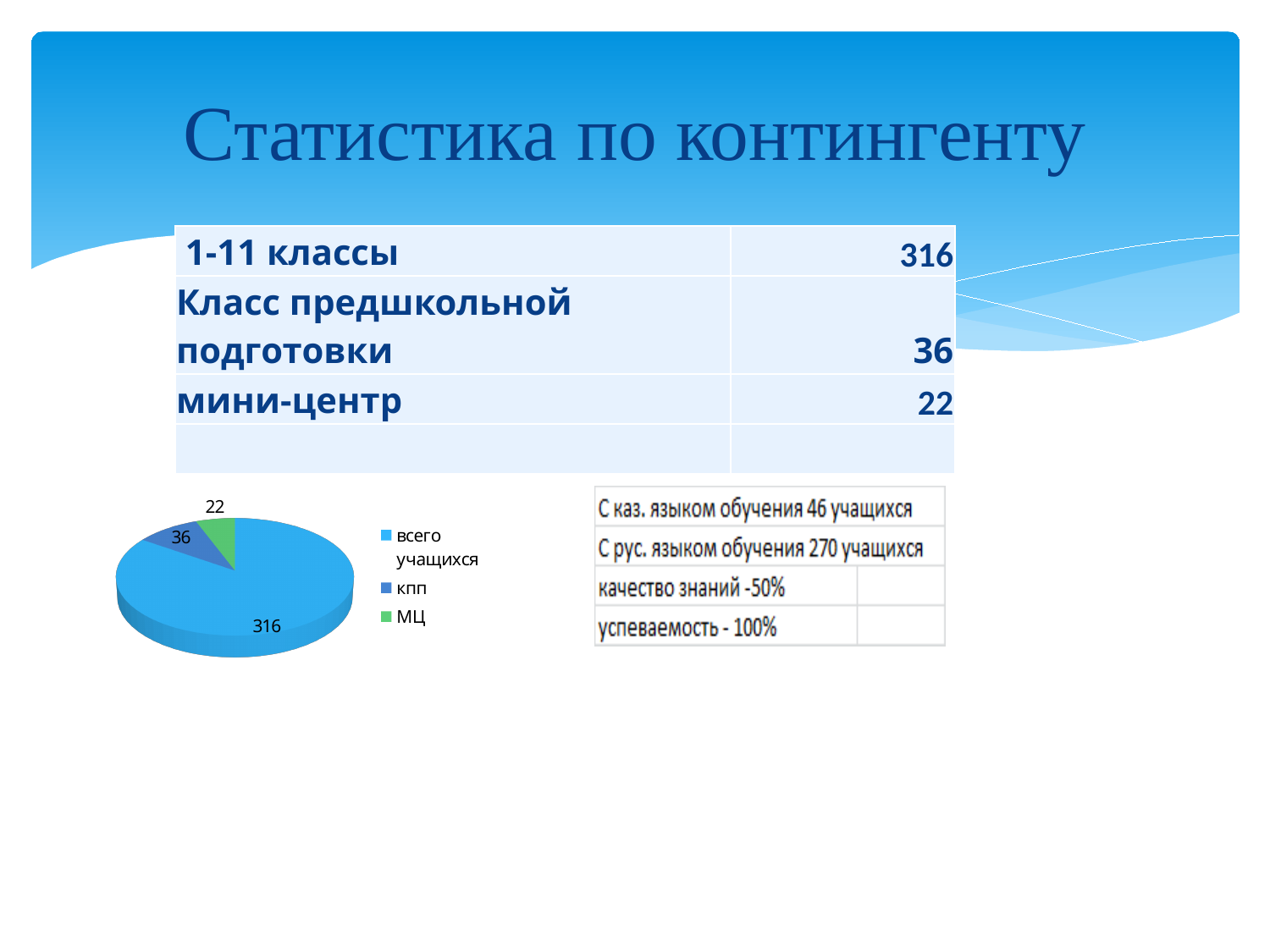
What type of chart is shown on the slide? pie chart What is the value of the "кпп" slice in the pie chart? 36 What colour is the "МЦ" slice in the pie chart? green What is the difference between the "всего учащихся" and "кпп" values in the pie chart? 280 Which is larger in the pie chart, "кпп" or "МЦ"? кпп How many slices does the pie chart have? 3 Which category has the largest slice in the pie chart? всего учащихся How many entries does the pie chart legend list? 3 Which category has the smallest slice in the pie chart? МЦ What is the difference between the "кпп" and "МЦ" values in the pie chart? 14 What is the value of the "всего учащихся" slice in the pie chart? 316 What is the value of the "МЦ" slice in the pie chart? 22